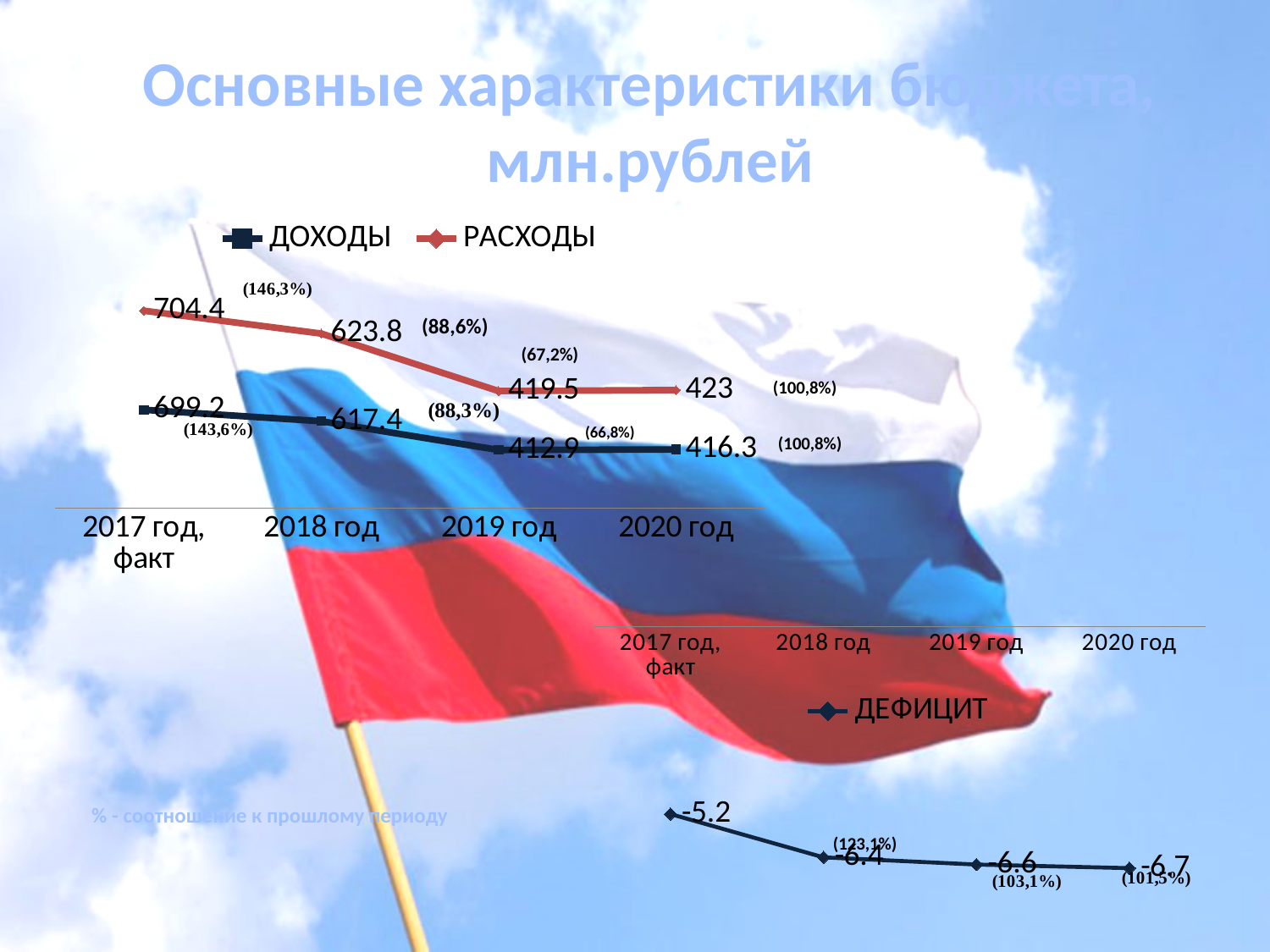
In the bottom chart (ДЕФИЦИТ), what is the difference between the values for 2017 год, факт and 2020 год? 1.5 What kind of chart is the bottom chart (ДЕФИЦИТ)? line chart In the top chart (ДОХОДЫ / РАСХОДЫ), how many series does the legend list? 2 In the bottom chart (ДЕФИЦИТ), what is the value for 2018 год? -6.4 In the top chart (ДОХОДЫ / РАСХОДЫ), which year has the highest value of РАСХОДЫ? 2017 год, факт In the top chart (ДОХОДЫ / РАСХОДЫ), which year has the lowest value of ДОХОДЫ? 2019 год In the top chart (ДОХОДЫ / РАСХОДЫ), how many years are shown on the x axis? 4 In the top chart (ДОХОДЫ / РАСХОДЫ), what is the difference between РАСХОДЫ and ДОХОДЫ in 2018 год? 6.4 In the top chart (ДОХОДЫ / РАСХОДЫ), what is the value of РАСХОДЫ for 2017 год, факт? 704.4 In the top chart (ДОХОДЫ / РАСХОДЫ), what is the value of ДОХОДЫ for 2019 год? 412.9 In the top chart (ДОХОДЫ / РАСХОДЫ), what is the value of ДОХОДЫ for 2020 год? 416.3 In the top chart (ДОХОДЫ / РАСХОДЫ), which is larger in 2020 год: ДОХОДЫ or РАСХОДЫ? РАСХОДЫ